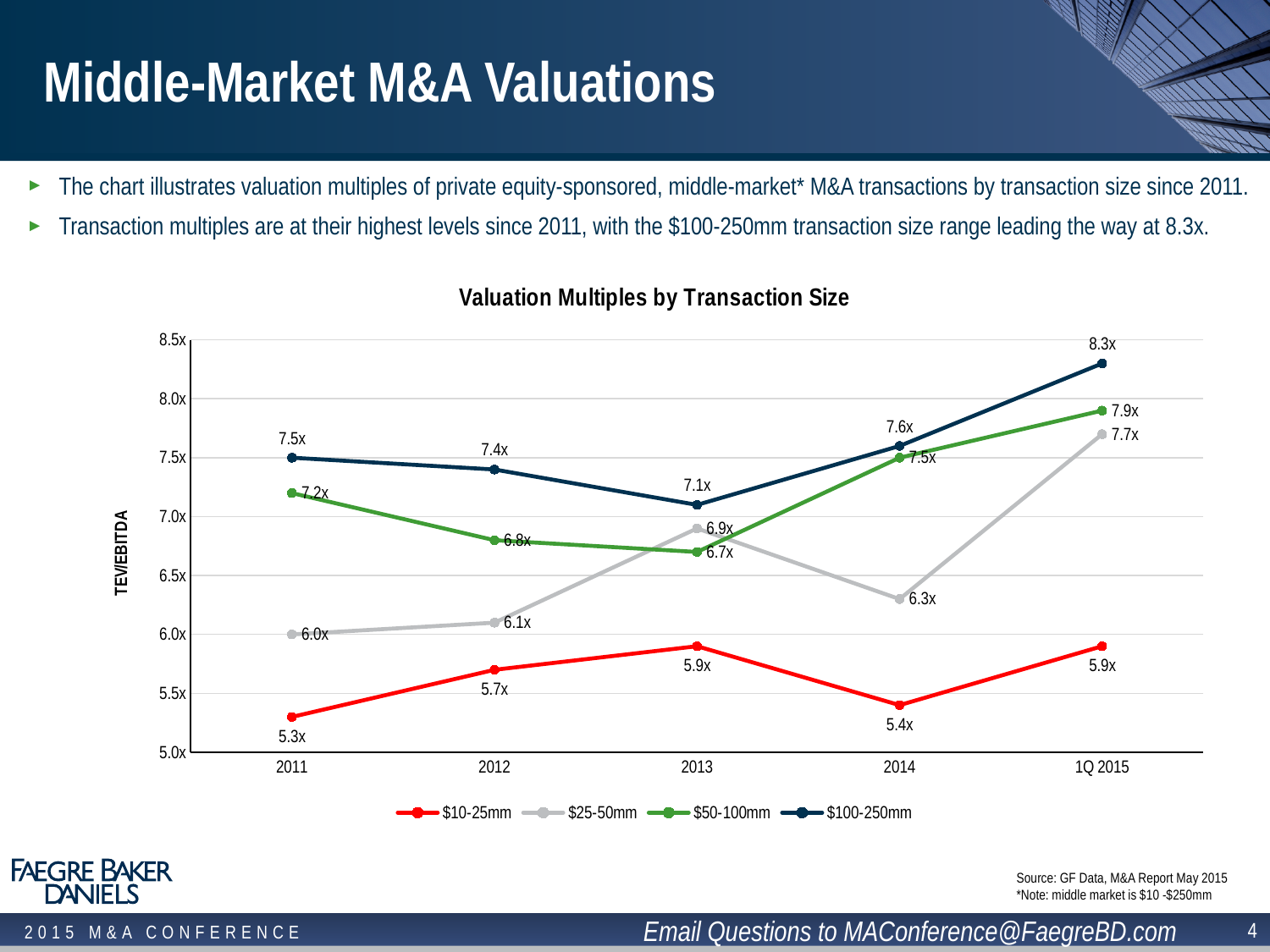
Which is larger in 2014: the $50-100mm value or the $25-50mm value? $50-100mm How many time periods are shown on the x axis? 5 What type of chart is shown on the slide? Line chart What is the valuation multiple for the $25-50mm series in 2013? 6.9x What is the title of the chart? Valuation Multiples by Transaction Size What is the difference between the $100-250mm and $10-25mm values in 2011? 2.2x Which series has the highest value in 1Q 2015? $100-250mm How many series does the legend list? 4 What is the valuation multiple for the $10-25mm series in 2014? 5.4x Does the $25-50mm series rise or fall from 2014 to 1Q 2015? Rise In which period is the $50-100mm series at its lowest value? 2013 What is the valuation multiple for the $100-250mm series in 1Q 2015? 8.3x